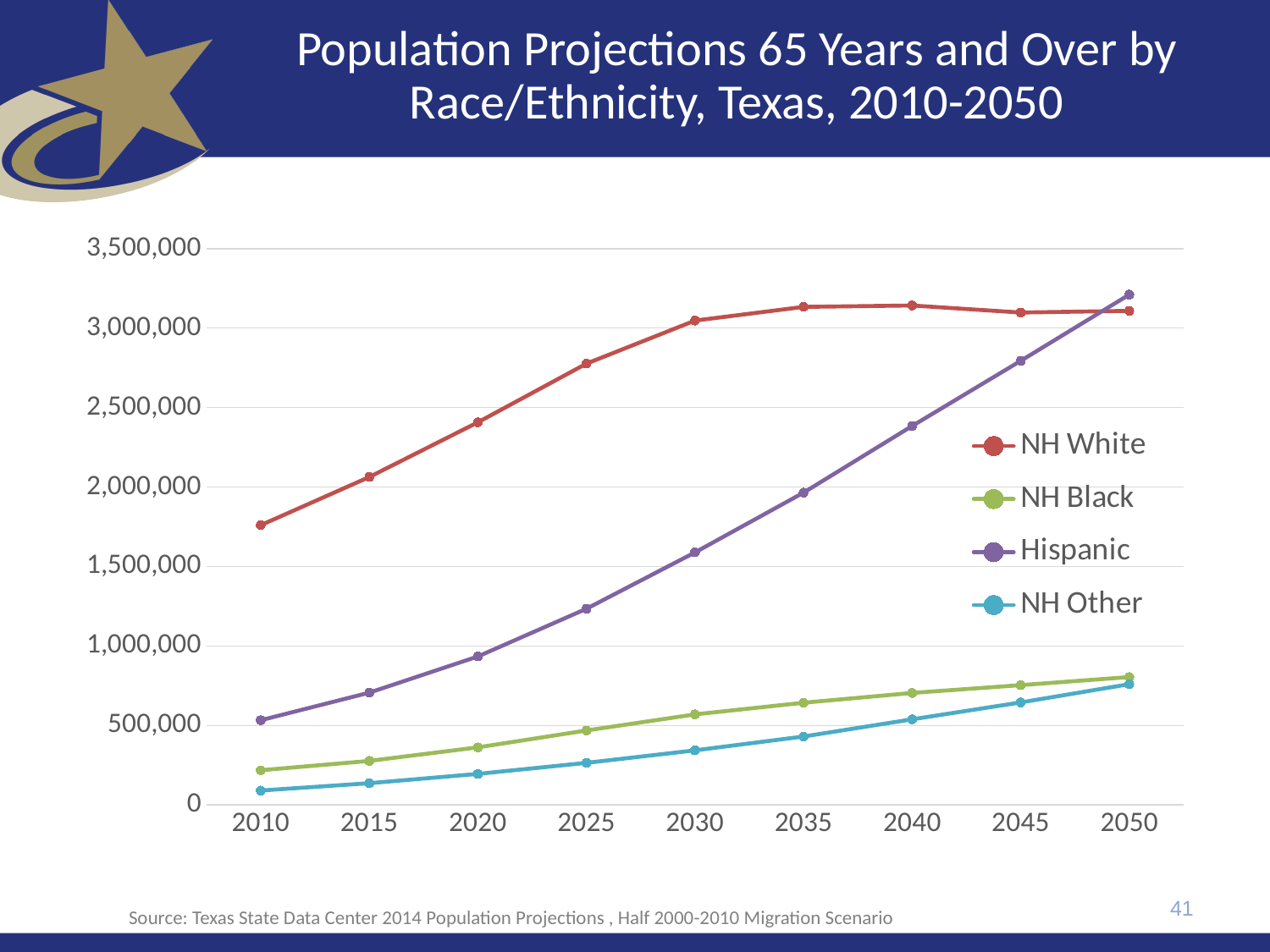
How many series does the legend list? 4 Which series has the highest value in 2010? NH White What kind of chart is shown on the slide? Line chart How many years are plotted along the x axis? 9 Is the value for NH White in 2010 greater or less than 1,500,000? greater Which series has the highest value in 2050? Hispanic Which series has the lowest value in 2010? NH Other In 2030, which is larger: the value for NH White or the value for Hispanic? NH White Is the value for NH Black in 2050 greater or less than 1,000,000? less Does the Hispanic line rise or fall from 2010 to 2050? rise Is the value for Hispanic in 2050 greater or less than 3,000,000? greater